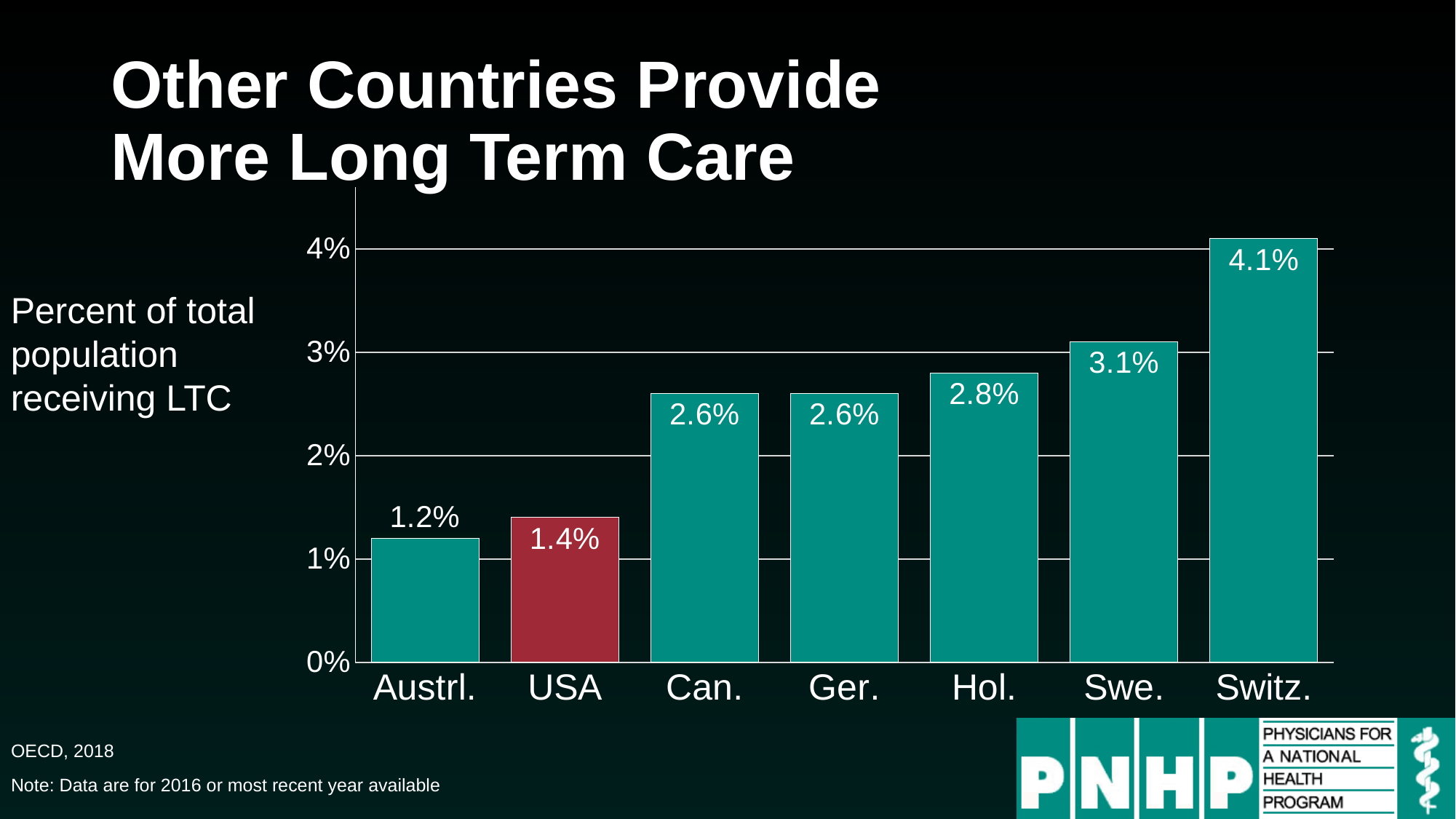
What is the value for USA? 1.4% What kind of chart is shown on the slide? bar chart Is the value for Can. greater or less than 2%? greater What is the difference between the values for Swe. and Hol.? 0.3% What is the difference between the values for Switz. and USA? 2.7% Which is larger, the value for Swe. or the value for Ger.? Swe. Which country has the highest value? Switz. Which country has the lowest value? Austrl. What is the value for Hol.? 2.8% How many countries are shown in the chart? 7 What is the value for Switz.? 4.1% Which bar is coloured differently (red) from the others? USA